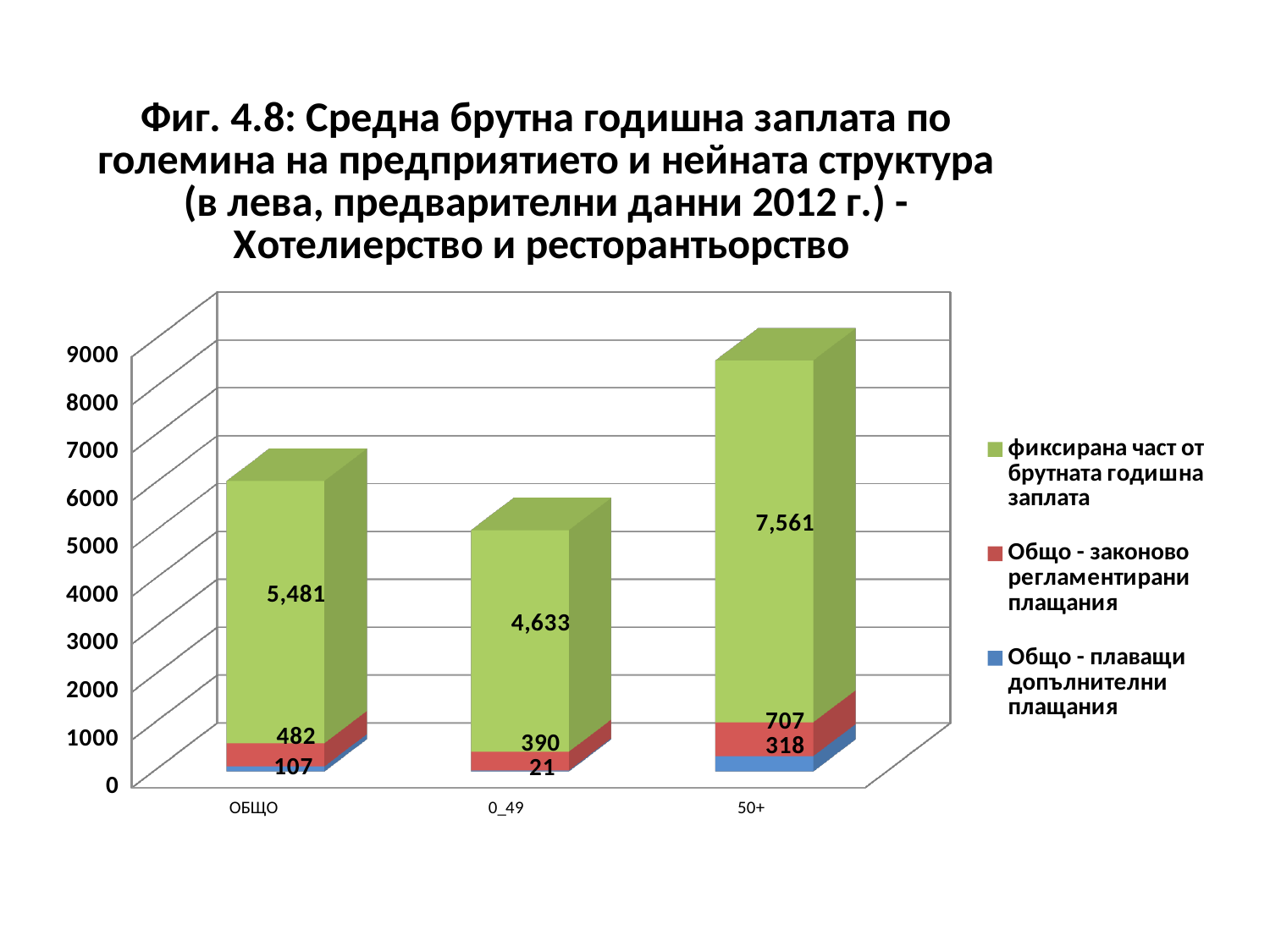
How many series does the legend list? 3 Which category has the lowest value for 'Общо - плаващи допълнителни плащания'? 0_49 What is the value of the fixed part of gross annual salary (фиксирана част от брутната годишна заплата) for the 50+ category? 7,561 What is the value of 'Общо - плаващи допълнителни плащания' for the ОБЩО category? 107 Which is larger: 'Общо - законово регламентирани плащания' for ОБЩО or for 50+? 50+ What is the total of the stacked bar for the ОБЩО category? 6,070 Which category has the highest value for the fixed part of gross annual salary? 50+ What kind of chart is shown on the slide? Stacked bar chart What is the difference between the fixed part of gross annual salary for 50+ and for 0_49? 2,928 What is the value of 'Общо - законово регламентирани плащания' for the 0_49 category? 390 What is the total of the stacked bar for the 50+ category? 8,586 How many categories are shown on the x axis? 3